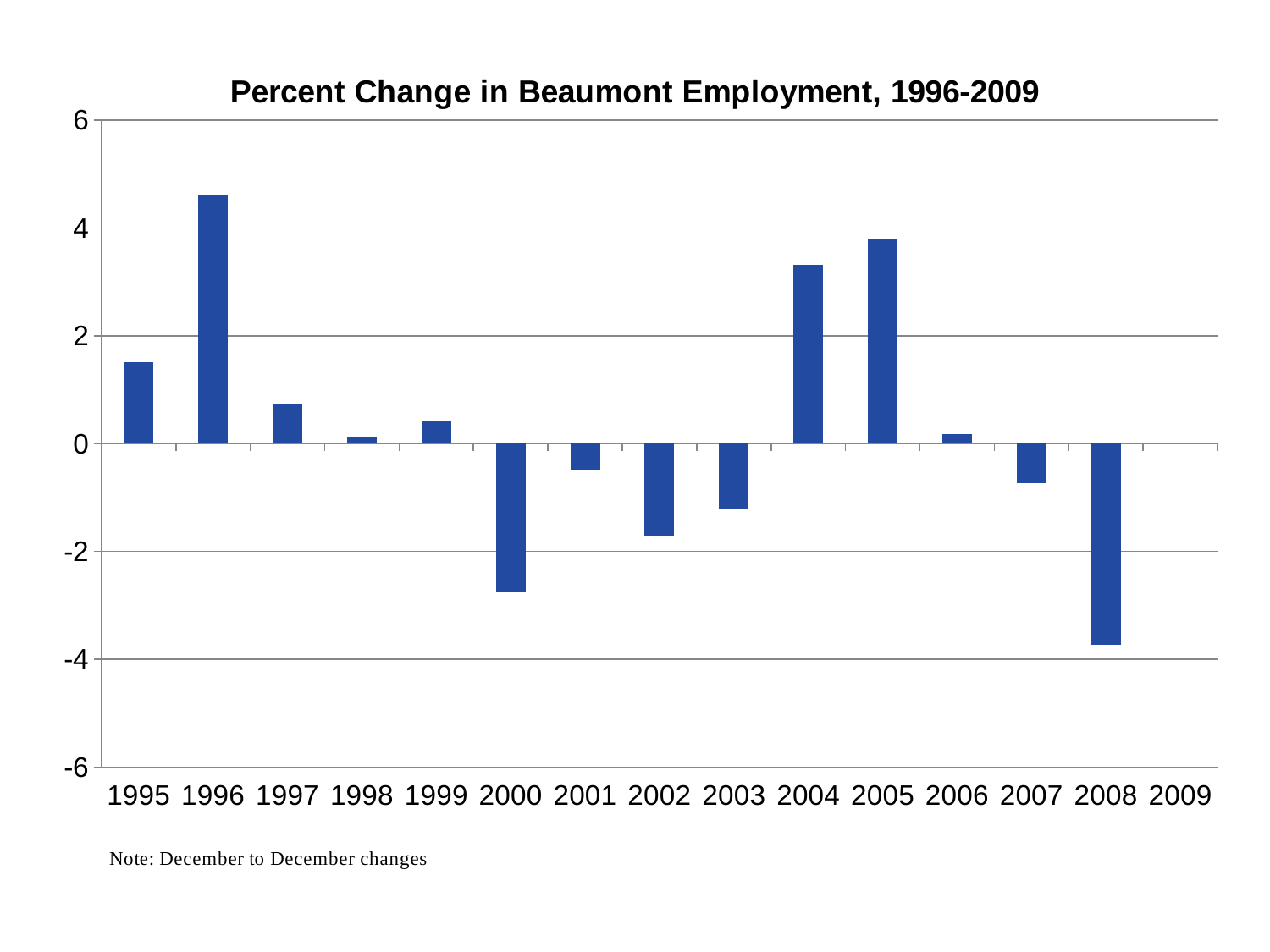
Which year has the larger percent change, 1996 or 2005? 1996 How many years are labeled on the x axis? 15 Which year has the highest percent change in Beaumont employment? 1996 Do the values rise or fall from 1996 to 1998? fall What kind of chart is shown on the slide? bar chart Is the value for 2005 greater or less than 4? less What is the title of the chart? Percent Change in Beaumont Employment, 1996-2009 Is the value for 2004 greater or less than 2? greater Which year has the larger percent change, 2000 or 2008? 2000 Is the value for 2008 greater or less than -2? less Which year has the lowest percent change in Beaumont employment? 2008